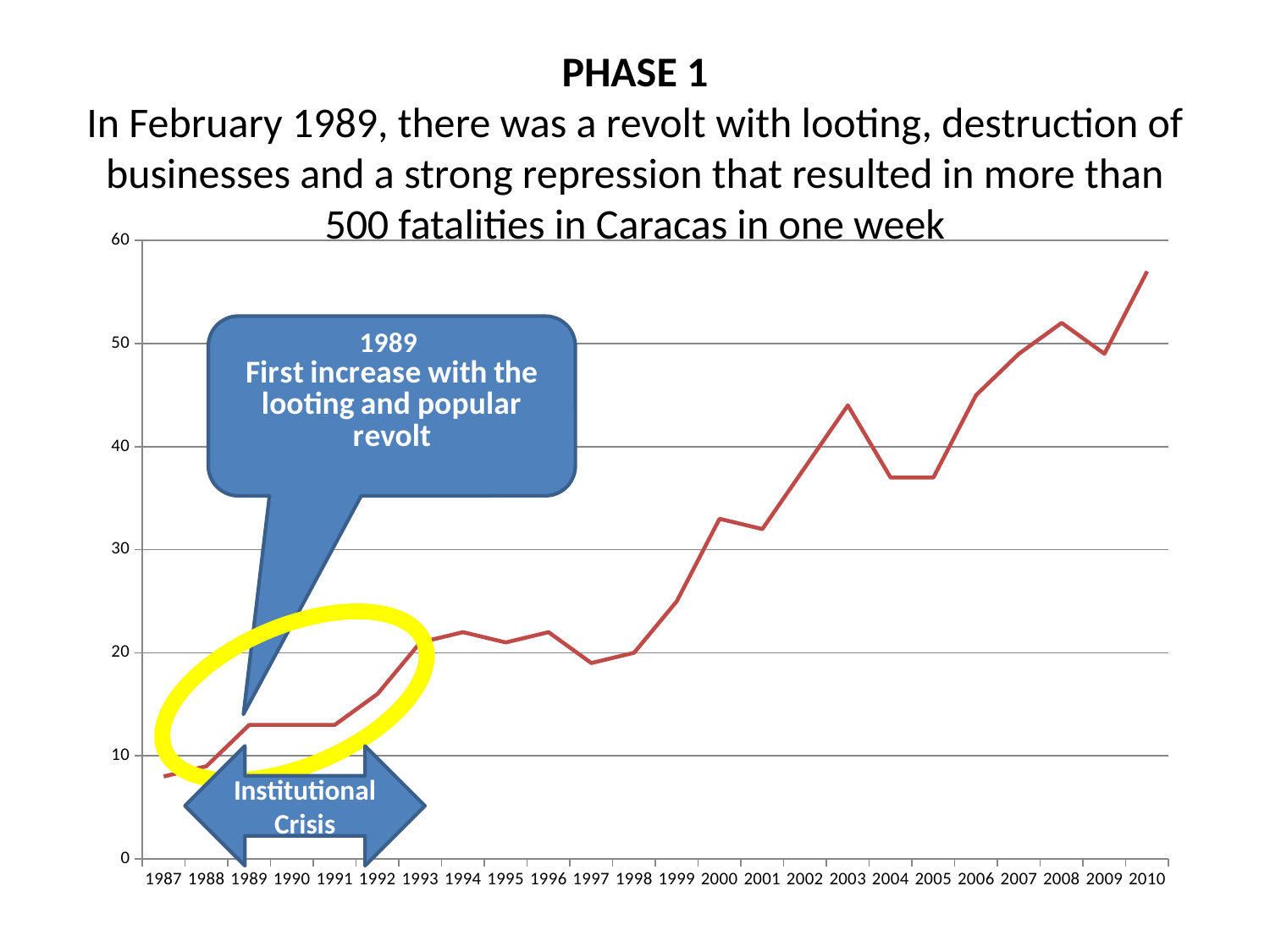
What kind of chart is shown on the slide? line chart Overall, do the values rise or fall from 1987 to 2010? rise Is the value for 2000 greater or less than 30? greater What label is written on the double-headed arrow near the bottom of the chart? Institutional Crisis Which year has the highest value on the chart? 2010 Is the value for 2003 greater or less than 40? greater Is the value for 2010 greater or less than 50? greater Which year has the larger value, 2003 or 2004? 2003 How many years are plotted along the x axis? 24 Which year has the larger value, 1999 or 2000? 2000 Which year has the lowest value on the chart? 1987